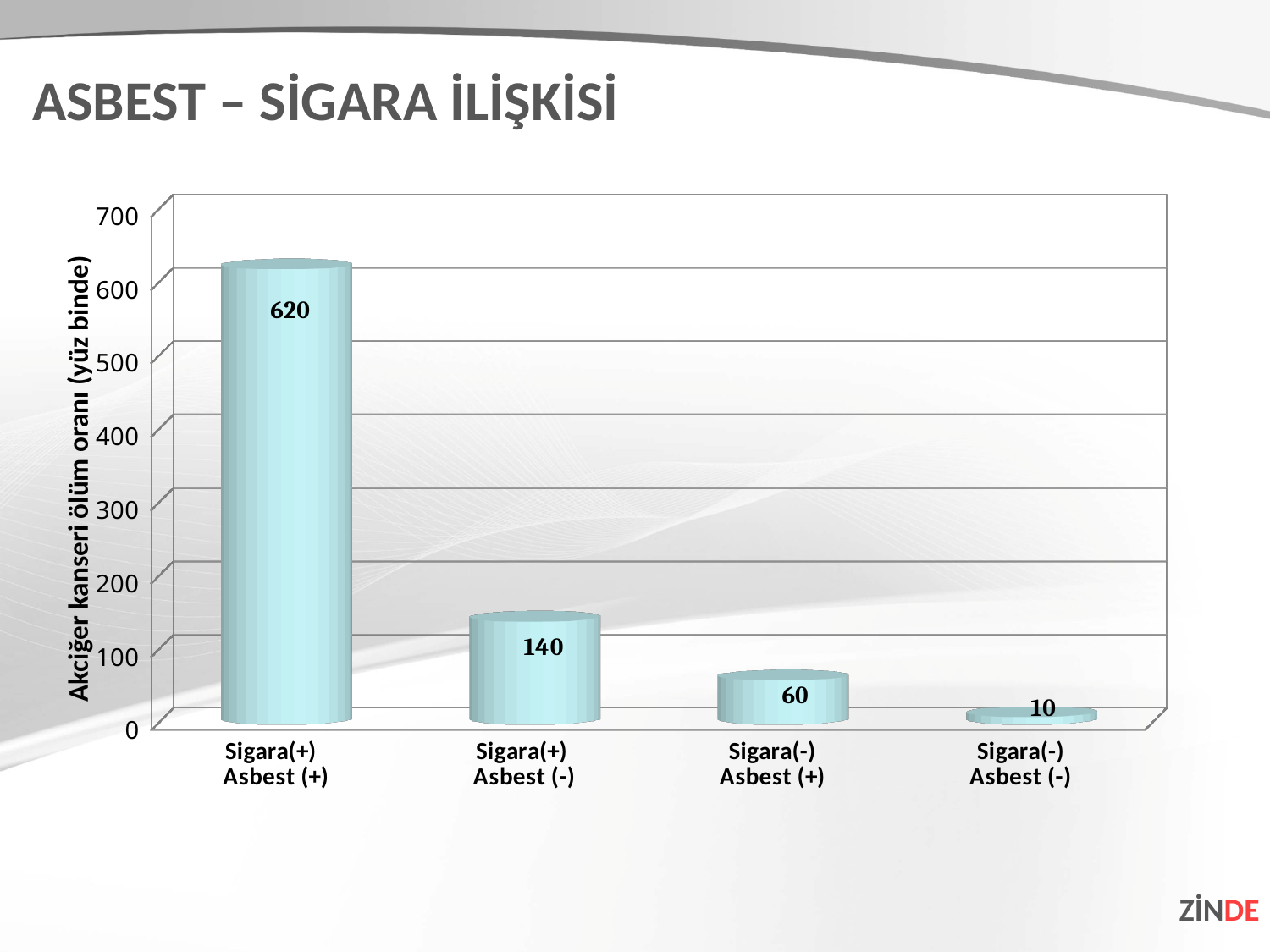
What is the value for Sigara(-) Asbest (+)? 60 What is the value for Sigara(-) Asbest (-)? 10 Which is larger, the value for Sigara(+) Asbest (-) or the value for Sigara(-) Asbest (+)? Sigara(+) Asbest (-) What is the value for Sigara(+) Asbest (-)? 140 What is the value for Sigara(+) Asbest (+)? 620 Which category has the highest value? Sigara(+) Asbest (+) Is the value for Sigara(+) Asbest (+) greater or less than 600? greater How many categories are shown on the x axis? 4 What is the label of the vertical axis? Akciğer kanseri ölüm oranı (yüz binde) What kind of chart is shown on the slide? bar chart What is the difference between the values for Sigara(+) Asbest (+) and Sigara(+) Asbest (-)? 480 Which category has the lowest value? Sigara(-) Asbest (-)